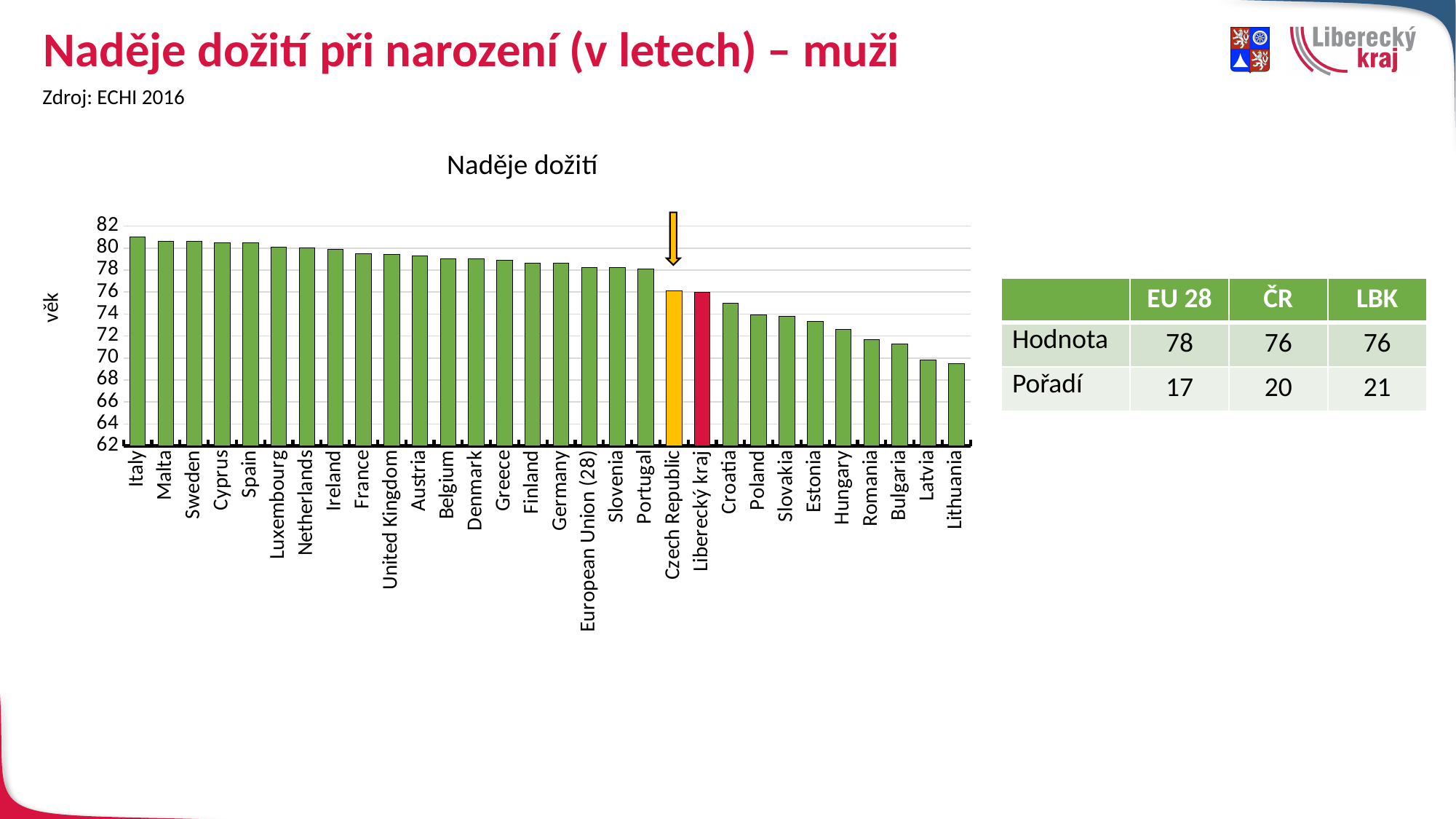
Do the values rise or fall from left to right along the x axis? fall What is the title of the chart? Naděje dožití What kind of chart is shown on the slide? bar chart How many countries/regions are shown on the x axis of the chart? 30 Is the value for Lithuania greater or less than 70? less What colour is the bar for Czech Republic? yellow Which category has the lowest value in the chart? Lithuania Which category has the highest value in the chart? Italy Which has the larger value, Germany or Hungary? Germany Is the value for Italy greater or less than 80? greater Is the value for Croatia greater or less than 76? less